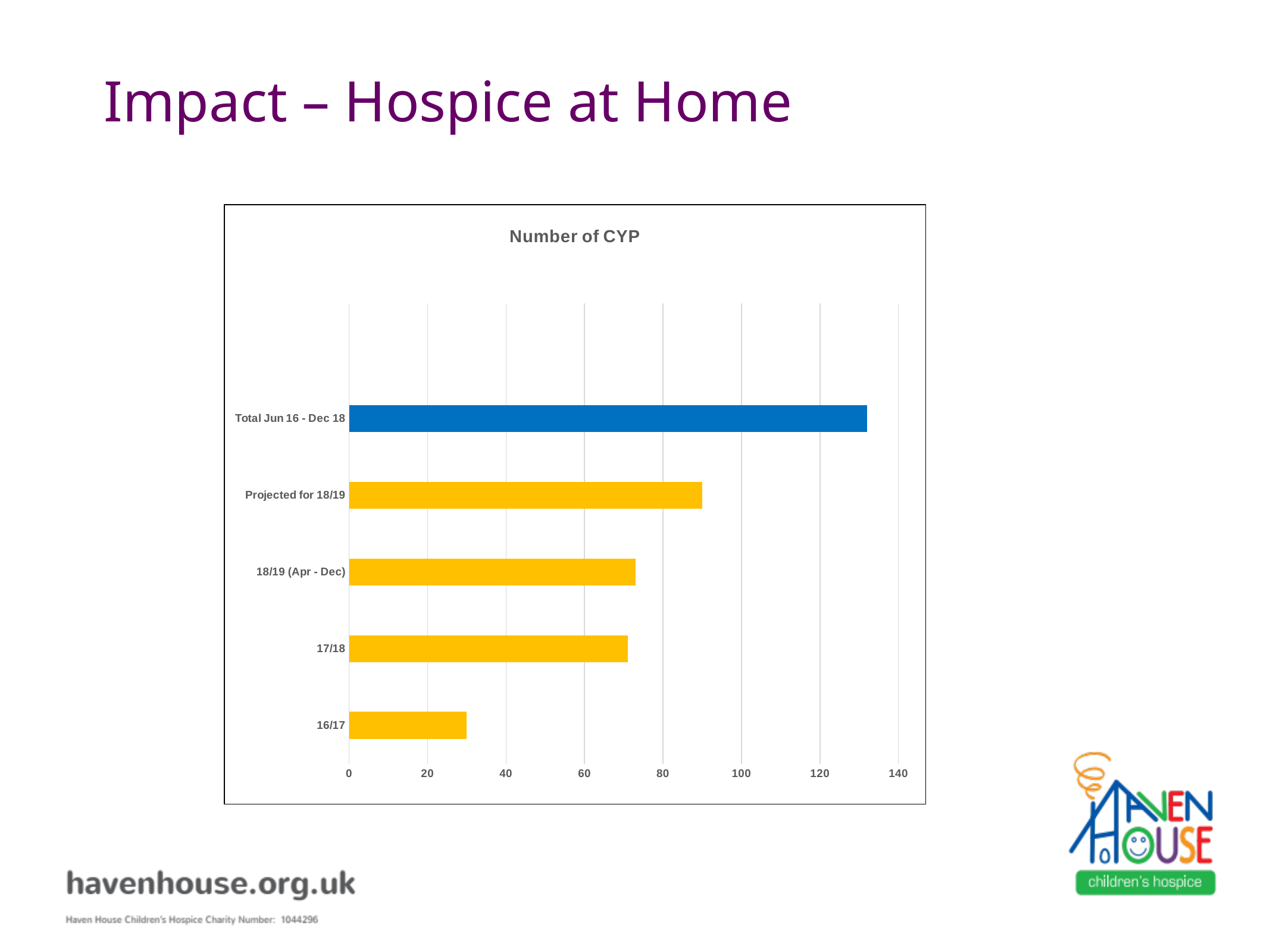
What kind of chart is shown on the slide? bar chart Which is larger, the value for Projected for 18/19 or the value for 17/18? Projected for 18/19 Is the value for 16/17 greater or less than 40? less Is the value for Total Jun 16 - Dec 18 greater or less than 120? greater Is the value for 17/18 greater or less than 60? greater What colour is the bar for Total Jun 16 - Dec 18? blue What is the title of the chart? Number of CYP Which category has the lowest value? 16/17 How many categories (bars) does the chart show? 5 Which category has the highest value? Total Jun 16 - Dec 18